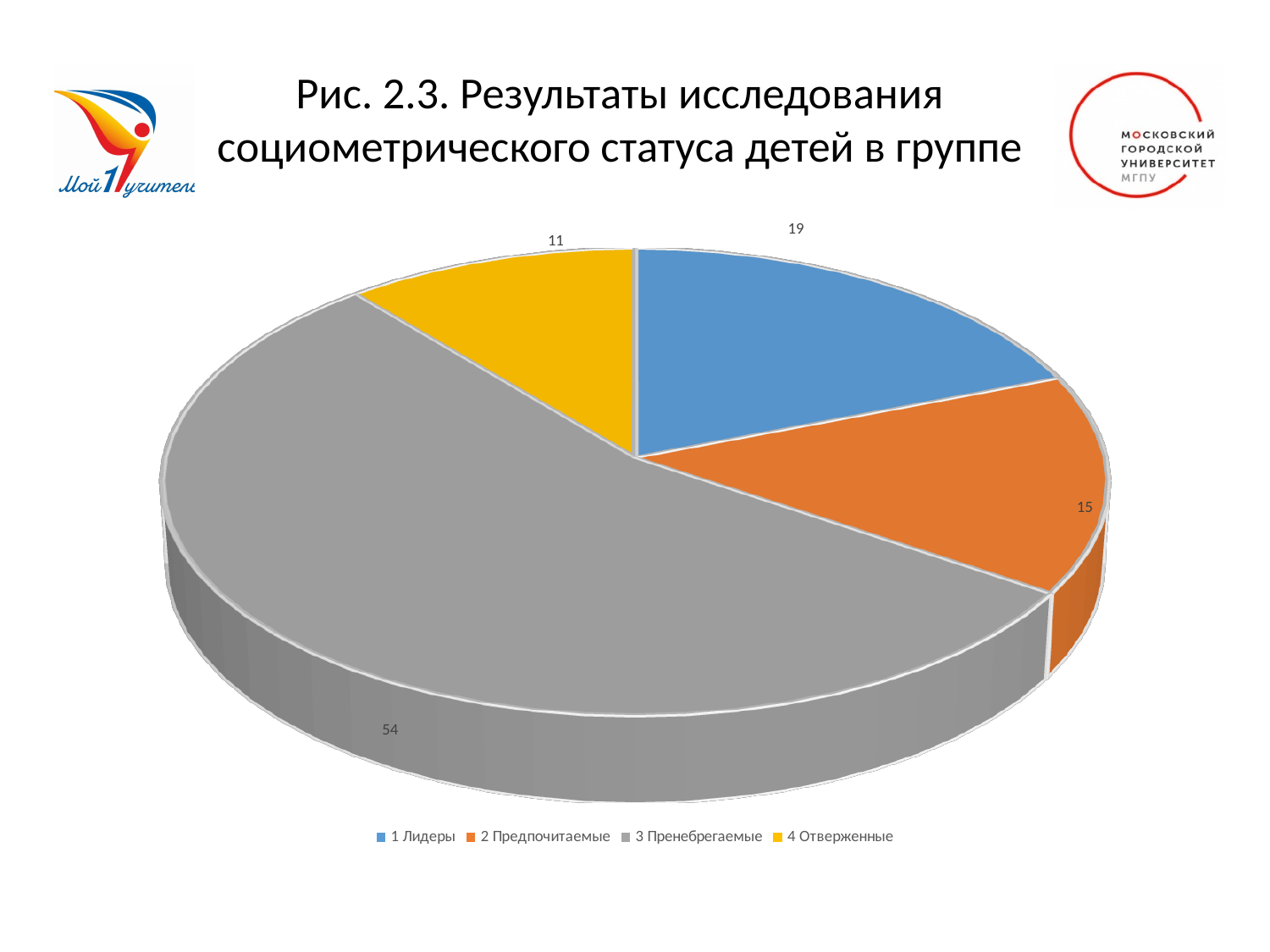
What is the difference between the values for 3 Пренебрегаемые and 1 Лидеры? 35 Which colour represents 4 Отверженные in the legend? Yellow What value is shown for the slice labelled 3 Пренебрегаемые? 54 What kind of chart is shown on the slide? Pie chart What is the difference between the values for 1 Лидеры and 4 Отверженные? 8 How many slices does the pie chart have? 4 What value is shown for the slice labelled 2 Предпочитаемые? 15 Which category has the smallest slice of the pie? 4 Отверженные Which is larger, the value for 1 Лидеры or the value for 2 Предпочитаемые? 1 Лидеры What value is shown for the slice labelled 4 Отверженные? 11 What value is shown for the slice labelled 1 Лидеры? 19 Which category has the largest slice of the pie? 3 Пренебрегаемые